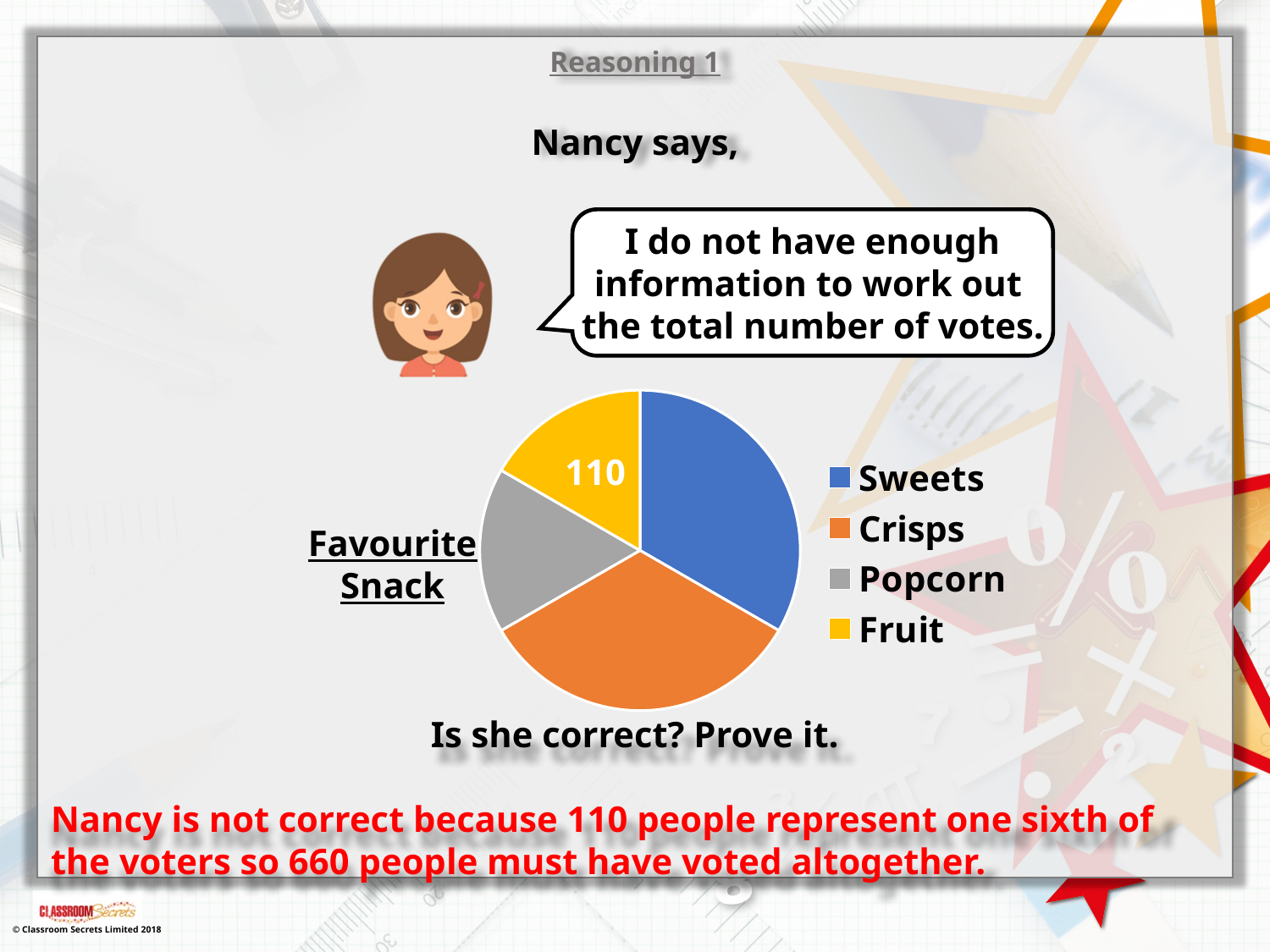
According to the slide, what fraction of the voters does the 110 slice represent? one sixth What value is printed on the Fruit slice of the pie chart? 110 Which colour represents Popcorn in the pie chart? grey Which slice is larger, Sweets or Fruit? Sweets According to the slide, how many people voted altogether? 660 What kind of chart is shown on the slide? pie chart How many entries does the legend list? 4 What is the title of the pie chart? Favourite Snack Which slice is larger, Crisps or Fruit? Crisps How many categories does the pie chart have? 4 Which slice is larger, Crisps or Popcorn? Crisps